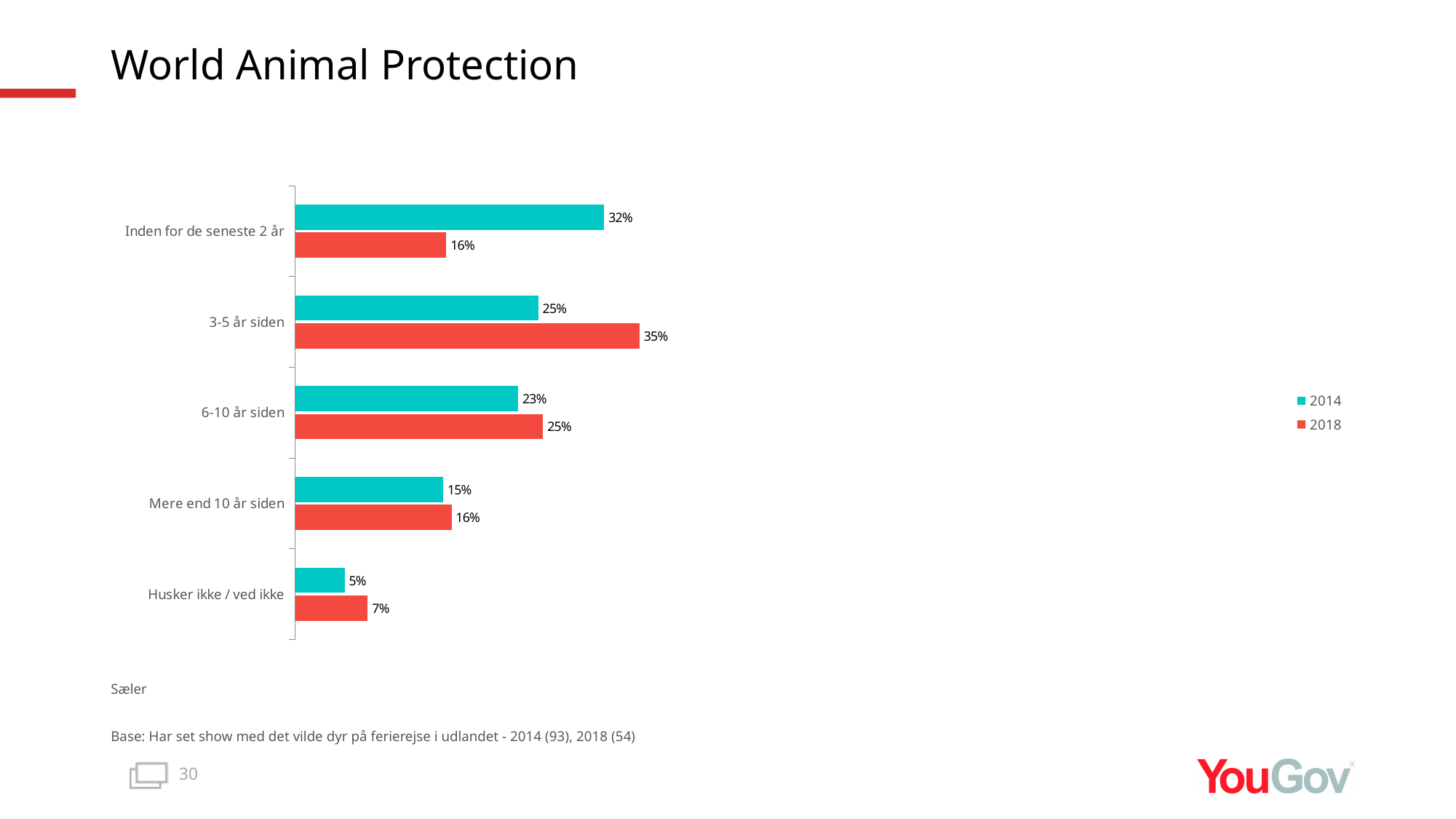
How many categories are shown on the chart? 5 How many series does the legend list? 2 What kind of chart is shown on the slide? Bar chart What is the difference between the 2014 and 2018 values for "Inden for de seneste 2 år"? 16% Which category has the highest 2018 value? 3-5 år siden Which colour represents the 2018 series? Red What is the 2014 value for "Mere end 10 år siden"? 15% Which category has the lowest 2014 value? Husker ikke / ved ikke What is the 2014 value for "Inden for de seneste 2 år"? 32% Which is larger for "6-10 år siden": the 2014 value or the 2018 value? 2018 What is the 2018 value for "3-5 år siden"? 35% What is the 2018 value for "Husker ikke / ved ikke"? 7%